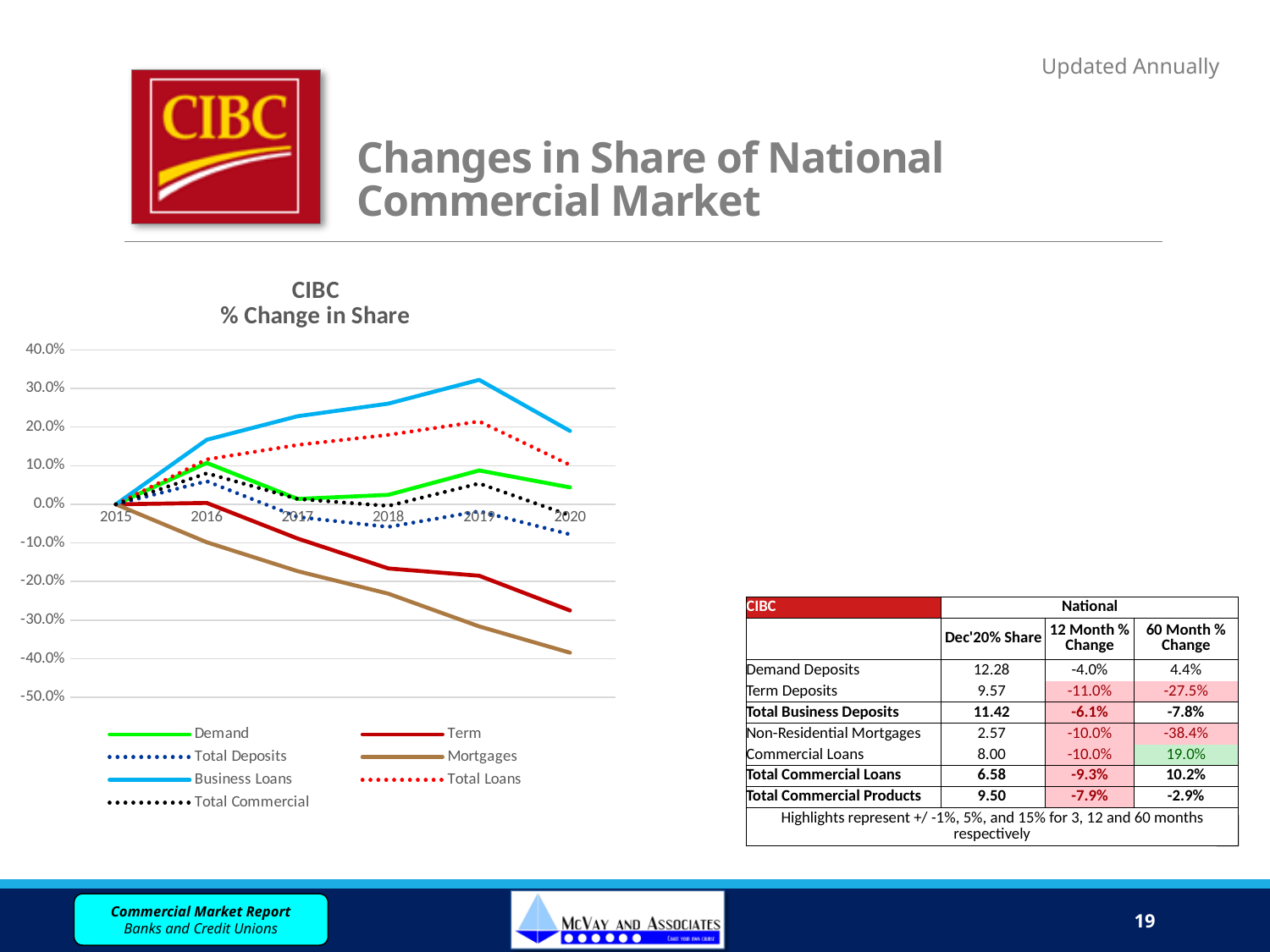
What kind of chart is the 'CIBC % Change in Share' chart? line chart In the 'CIBC % Change in Share' chart, is the value for Business Loans in 2017 greater or less than 20.0%? greater In the 'CIBC % Change in Share' chart, is the value for Term in 2020 greater or less than -20.0%? less In the 'CIBC % Change in Share' chart, which series has the lowest value in 2020? Mortgages In the 'CIBC % Change in Share' chart, which series has the highest value in 2020? Business Loans In the 'CIBC % Change in Share' chart, is the value for Mortgages in 2020 greater or less than -30.0%? less How many series does the legend of the 'CIBC % Change in Share' chart list? 7 How many years are shown on the x axis of the 'CIBC % Change in Share' chart? 6 In the 'CIBC % Change in Share' chart, which is larger in 2019: Demand or Total Commercial? Demand In the 'CIBC % Change in Share' chart, does the Mortgages series rise or fall from 2015 to 2020? fall What is the first year shown on the x axis of the 'CIBC % Change in Share' chart? 2015